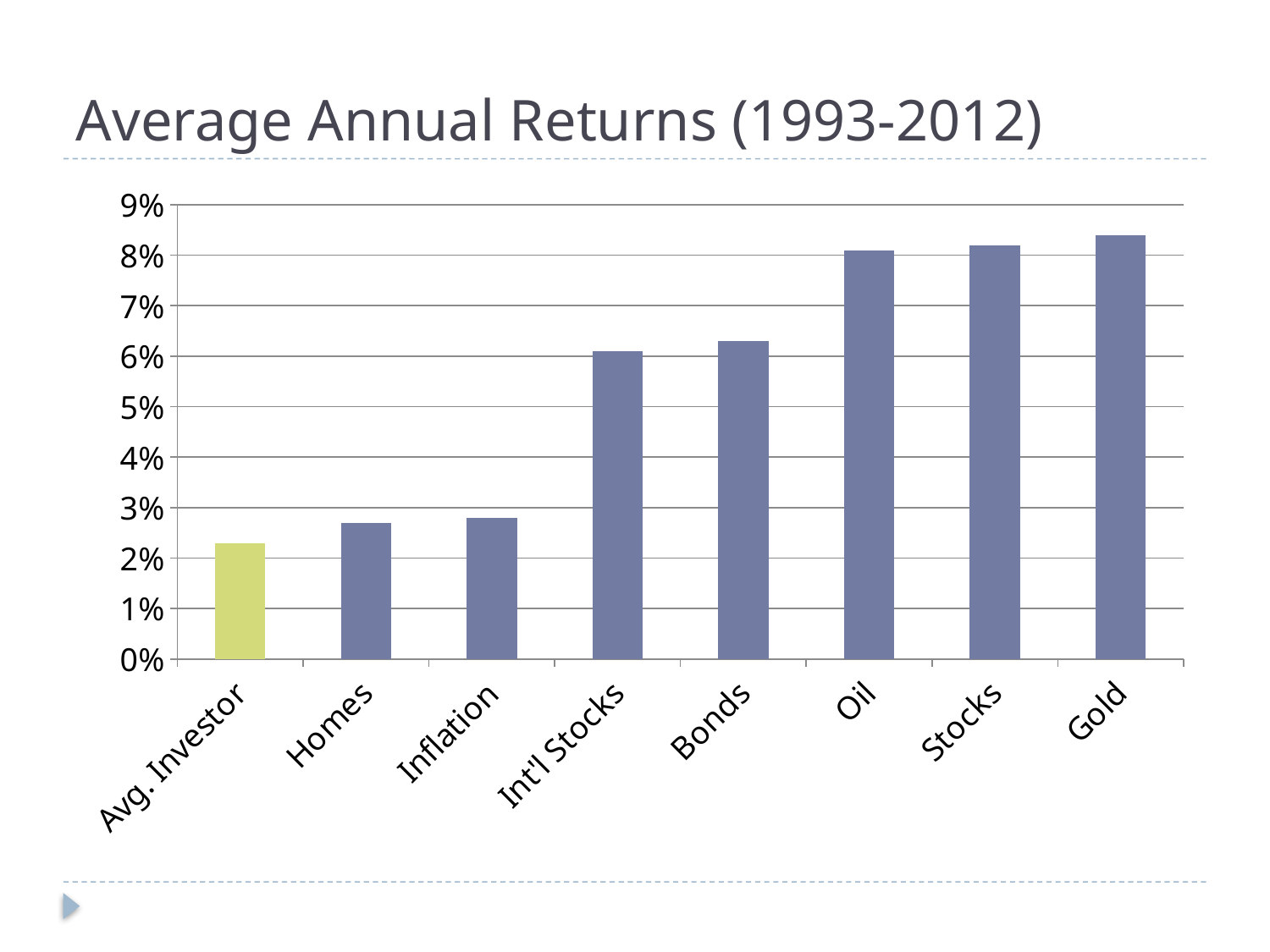
Which is larger, the value for Oil or the value for Bonds? Oil Do the values generally rise or fall moving from left to right along the x axis? rise Which category has the lowest average annual return? Avg. Investor Is the value for Gold greater or less than 8%? greater Which is larger, the value for Inflation or the value for Int'l Stocks? Int'l Stocks How many categories are plotted on the chart? 8 Which category's bar is shown in a different colour (yellow-green) from the others? Avg. Investor What kind of chart is shown on the slide? bar chart Is the value for Bonds greater or less than 7%? less Is the value for Avg. Investor greater or less than 3%? less